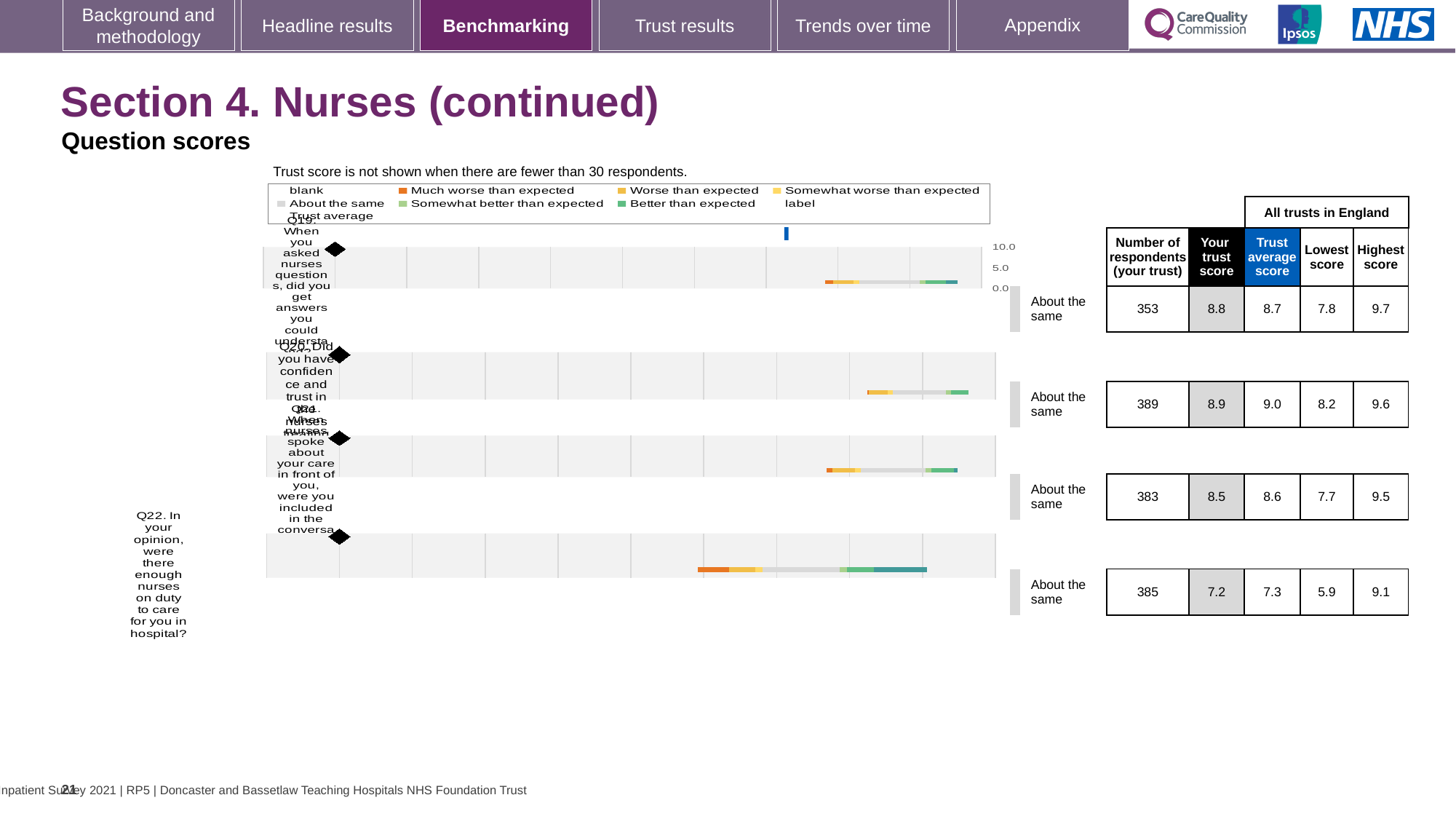
What benchmark category is shown for each of the four questions on this slide? About the same Which question has the highest 'Your trust score'? Q20 Which question has the lowest 'Your trust score'? Q22 For Q19, what is the difference between the highest score (9.7) and the lowest score (7.8) across all trusts in England? 1.9 What is the lowest score across all trusts in England for Q22? 5.9 What is the 'Your trust score' for Q22 (were there enough nurses on duty to care for you in hospital)? 7.2 What kind of chart is used to show the question scores on this slide? bar chart What is the trust average score for Q21 (were you included in the conversation)? 8.6 How many respondents from your trust answered Q20 (confidence and trust in the nurses)? 389 How many questions (categories) are plotted in the chart? 4 What is the maximum value shown on the chart's score axis? 10.0 For Q19, which is larger: your trust score or the trust average score? Your trust score